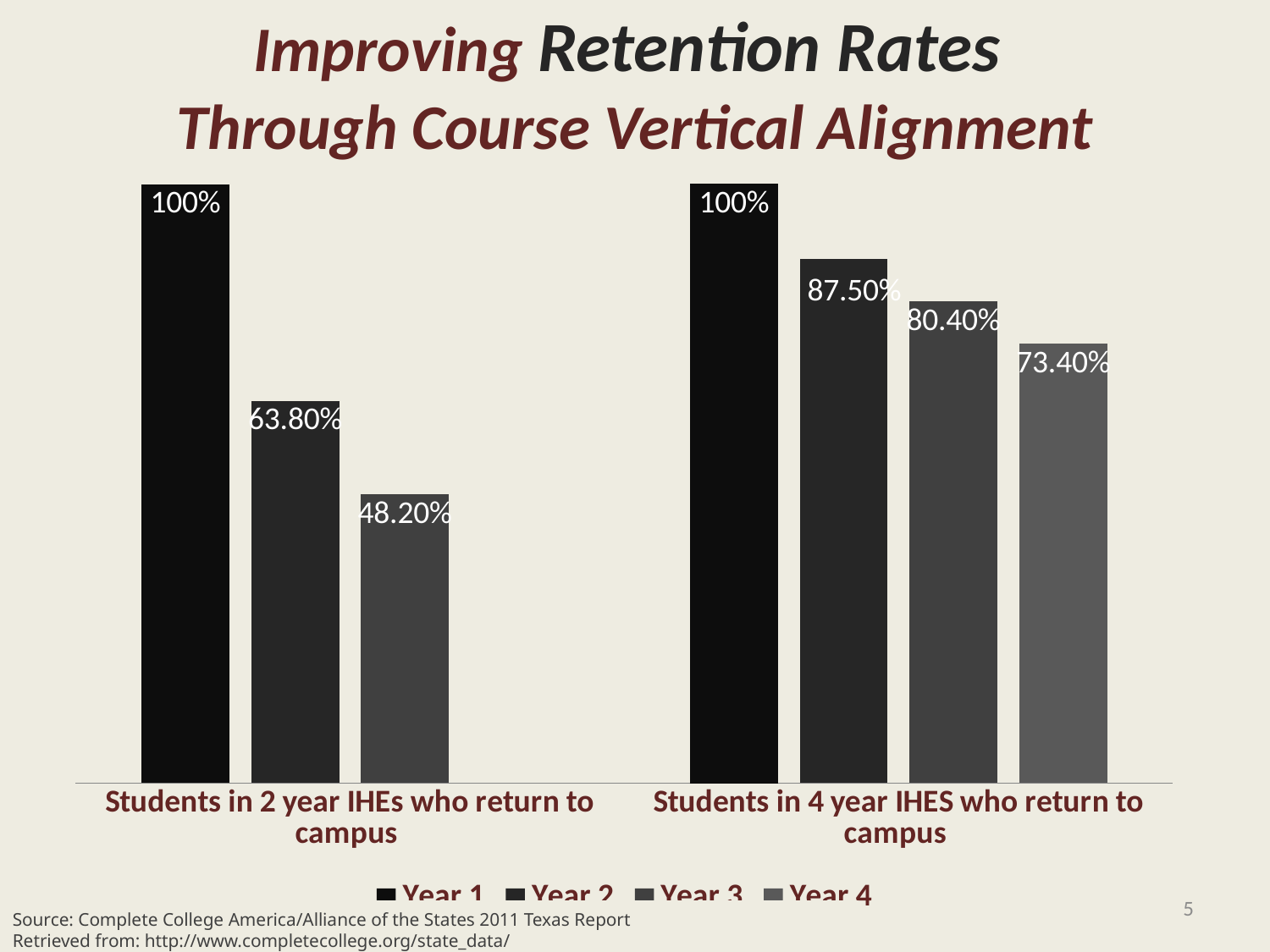
Which is larger: the Year 3 value for 2 year IHEs or the Year 4 value for 4 year IHES? Year 4 value for 4 year IHES What is the difference between the Year 2 values for 4 year IHES and 2 year IHEs? 23.70% What kind of chart is shown on the slide? Bar chart What is the difference between the Year 2 and Year 3 values for Students in 4 year IHES who return to campus? 7.10% What is the Year 4 value for Students in 4 year IHES who return to campus? 73.40% What is the Year 3 value for Students in 4 year IHES who return to campus? 80.40% How many categories are shown on the x axis? 2 What is the Year 3 value for Students in 2 year IHEs who return to campus? 48.20% Do the values for Students in 4 year IHES who return to campus rise or fall from Year 1 to Year 4? Fall How many series does the legend list? 4 Which series has the lowest value for Students in 4 year IHES who return to campus? Year 4 What is the Year 2 value for Students in 2 year IHEs who return to campus? 63.80%